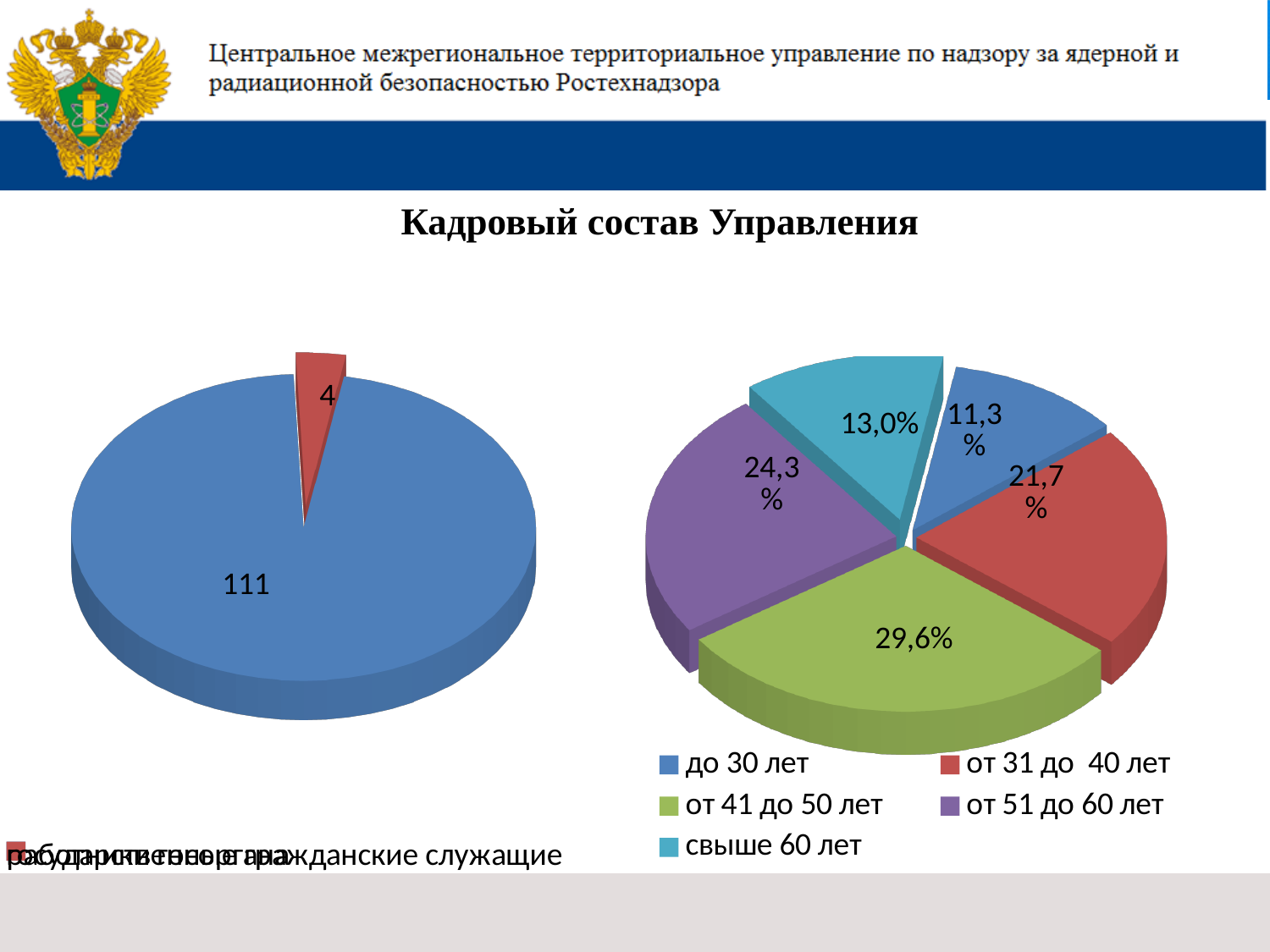
How many categories does the legend of the right pie chart list? 5 On the right pie chart, what is the difference between the shares for 'от 51 до 60 лет' and 'от 31 до 40 лет'? 2,6% On the right pie chart, what is the share for the category 'от 41 до 50 лет'? 29,6% On the left pie chart, what value is shown on the blue slice? 111 On the right pie chart, which age category has the smallest share? до 30 лет On the right pie chart, what is the share for the category 'свыше 60 лет'? 13,0% On the right pie chart, which is larger: the share for 'от 51 до 60 лет' or for 'свыше 60 лет'? от 51 до 60 лет On the left pie chart, what value is shown on the red slice? 4 What type of chart is shown on the right side of the slide? Pie chart On the right pie chart, which age category has the largest share? от 41 до 50 лет On the right pie chart, what is the share for the category 'до 30 лет'? 11,3% On the left pie chart, what is the total of the two slice values? 115